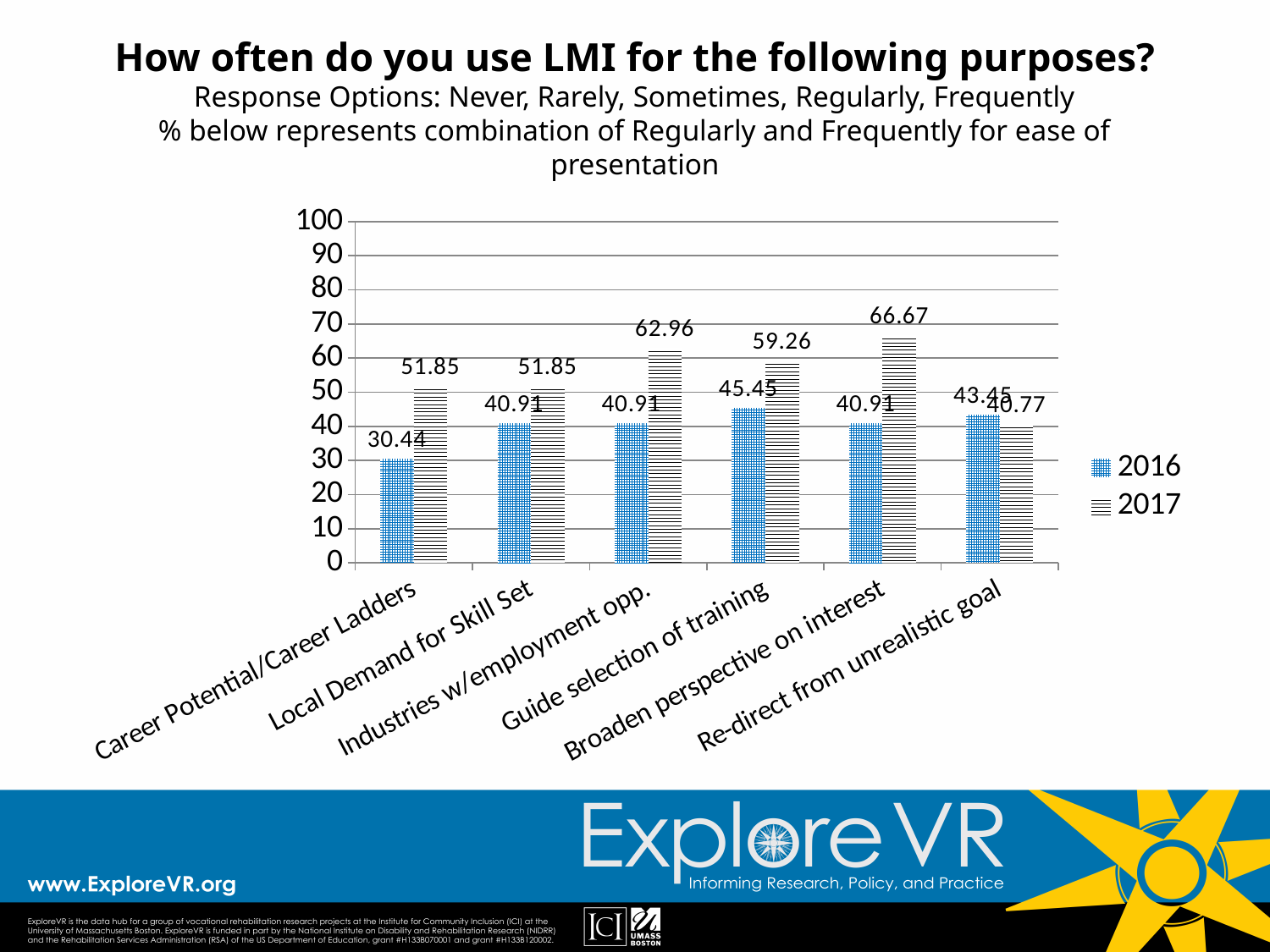
What is the 2016 value for Career Potential/Career Ladders? 30.44 Which category has the highest 2017 value? Broaden perspective on interest What is the difference between the 2017 and 2016 values for Career Potential/Career Ladders? 21.41 How many series does the legend list? 2 What is the 2016 value for Guide selection of training? 45.45 How many categories are shown on the x axis? 6 What is the 2017 value for Broaden perspective on interest? 66.67 What is the difference between the 2017 and 2016 values for Industries w/employment opp.? 22.05 Is the 2017 value for Industries w/employment opp. greater or less than 60? greater Which category has the lowest 2016 value? Career Potential/Career Ladders For Guide selection of training, which year has the larger value, 2016 or 2017? 2017 What kind of chart is shown on the slide? bar chart